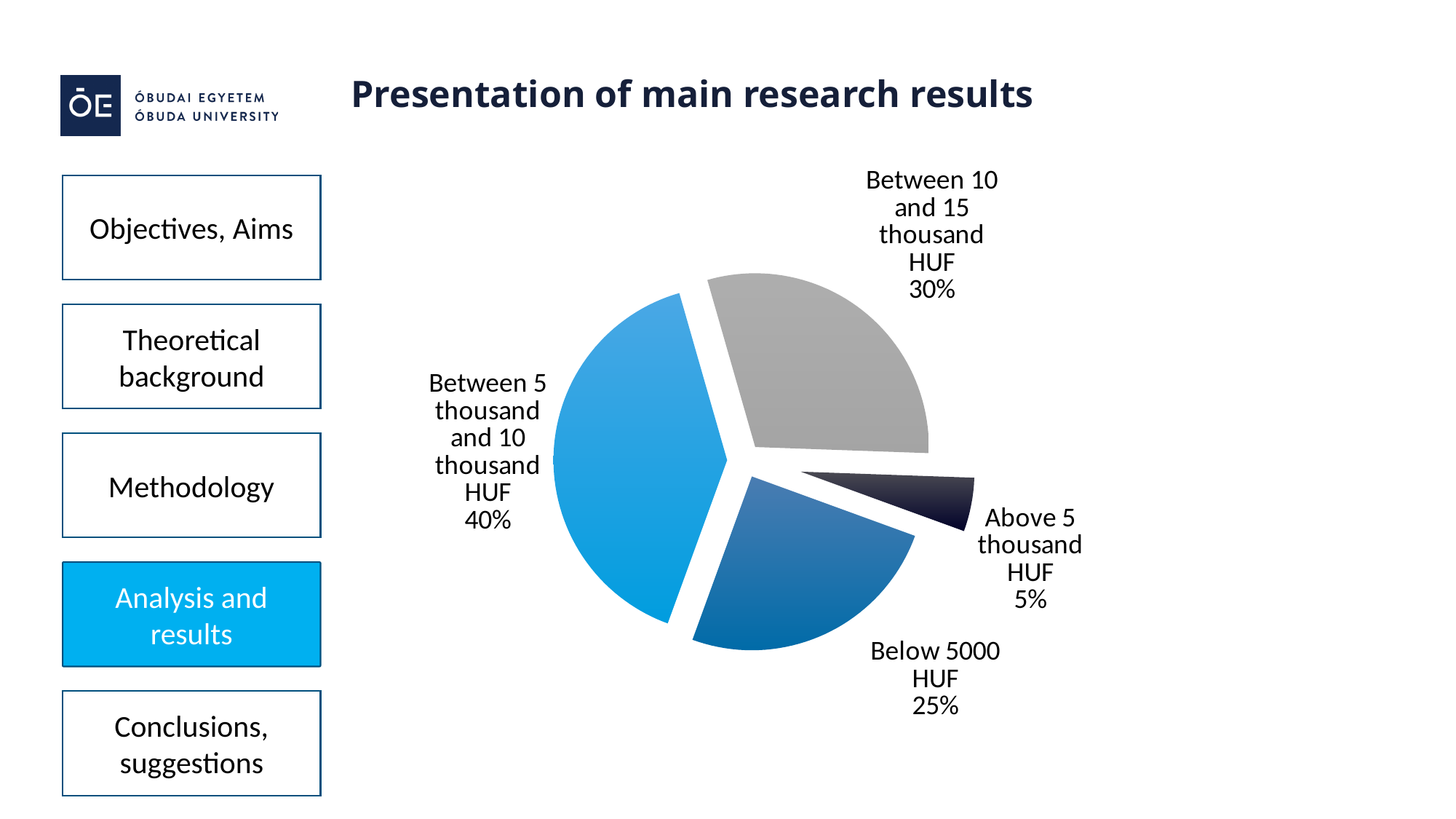
What share of the pie does the 'Between 10 and 15 thousand HUF' slice have? 30% What kind of chart is shown on the slide? Pie chart What share of the pie does the 'Above 5 thousand HUF' slice have? 5% Which is larger: the 'Between 10 and 15 thousand HUF' slice or the 'Below 5000 HUF' slice? Between 10 and 15 thousand HUF How many slices does the pie chart have? 4 What share of the pie does the 'Below 5000 HUF' slice have? 25% What is the difference in percentage points between the 'Between 10 and 15 thousand HUF' slice and the 'Above 5 thousand HUF' slice? 25% Which category has the smallest slice of the pie? Above 5 thousand HUF What is the title of the slide containing the pie chart? Presentation of main research results Which category has the largest slice of the pie? Between 5 thousand and 10 thousand HUF What is the difference in percentage points between the 'Between 5 thousand and 10 thousand HUF' slice and the 'Below 5000 HUF' slice? 15%